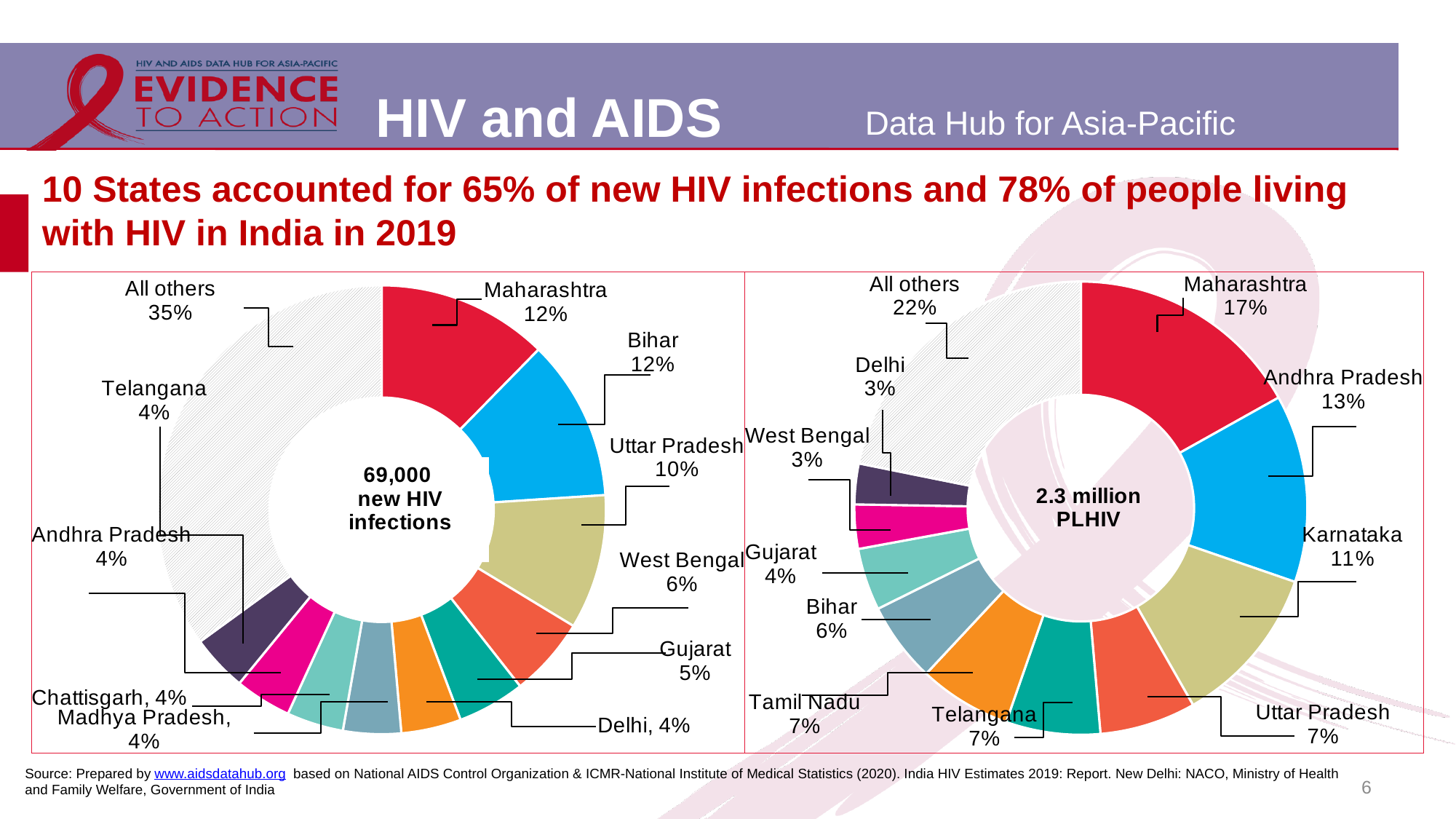
What text is shown in the centre of the right chart? 2.3 million PLHIV In the right chart (2.3 million PLHIV), what share is attributed to Karnataka? 11% How many slices does the left chart (69,000 new HIV infections) have? 11 In the right chart (2.3 million PLHIV), which is larger: the share for Maharashtra or the share for Andhra Pradesh? Maharashtra In the right chart (2.3 million PLHIV), what share is attributed to Andhra Pradesh? 13% In the right chart (2.3 million PLHIV), what is the difference between the shares for Maharashtra and All others? 5% In the left chart (69,000 new HIV infections), what is the difference between the shares for Maharashtra and West Bengal? 6% In the right chart (2.3 million PLHIV), which slice is the largest? All others In the left chart (69,000 new HIV infections), what is the share of the largest slice, All others? 35% In the left chart (69,000 new HIV infections), what share of new HIV infections is attributed to Uttar Pradesh? 10% What type of chart is used on this slide? Donut (pie) chart In the left chart (69,000 new HIV infections), what share is attributed to Gujarat? 5%